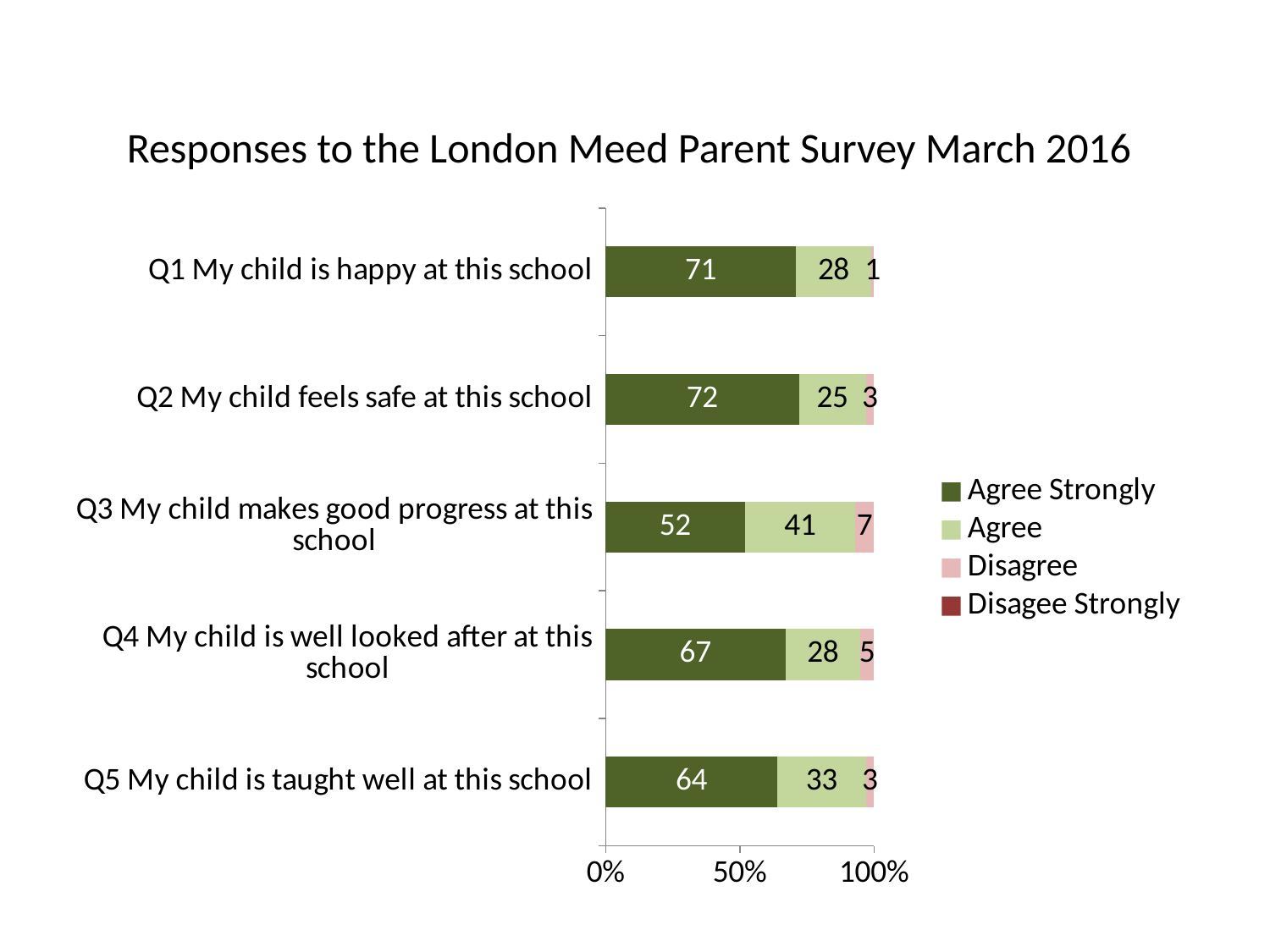
Which question has the lowest Agree Strongly value? Q3 My child makes good progress at this school Is the Agree Strongly value for Q3 My child makes good progress at this school greater or less than 50%? greater What is the Agree value for Q3 My child makes good progress at this school? 41 Which has the larger Agree Strongly value: Q4 My child is well looked after at this school or Q5 My child is taught well at this school? Q4 My child is well looked after at this school What is the Disagree value for Q4 My child is well looked after at this school? 5 Which question has the highest Disagree value? Q3 My child makes good progress at this school What is the difference between the Agree Strongly and Agree values for Q3 My child makes good progress at this school? 11 Which question has the lowest Disagree value? Q1 My child is happy at this school What is the Agree Strongly value for Q1 My child is happy at this school? 71 What kind of chart is shown on the slide? Stacked bar chart How many series does the legend list? 4 How many survey questions are shown on the chart? 5